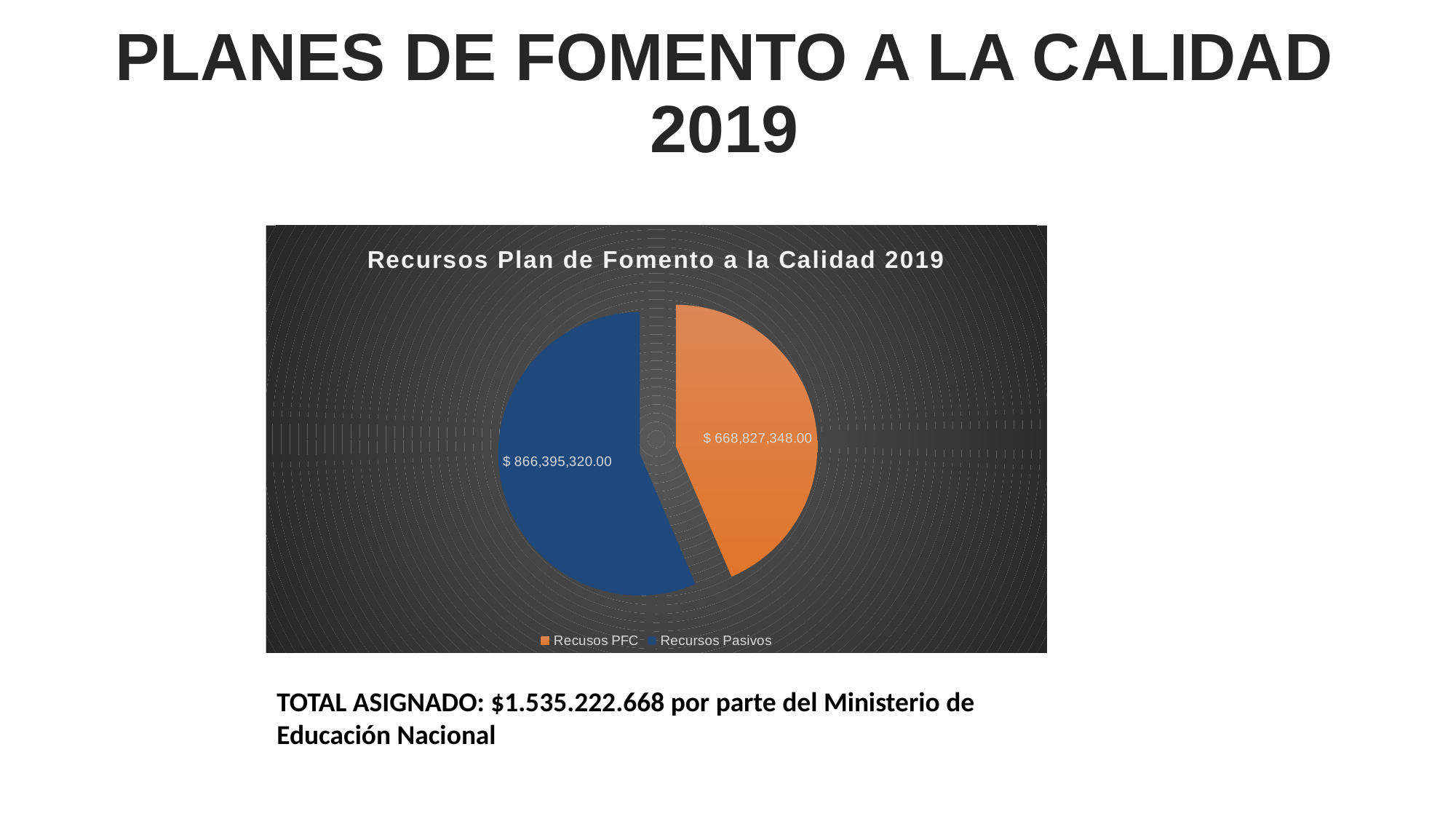
What colour is the Recursos Pasivos slice? blue What is the difference between Recursos Pasivos and Recusos PFC? $ 197,567,972.00 What is the value shown for Recursos Pasivos? $ 866,395,320.00 What is the total of the two slices in the pie chart? $ 1,535,222,668.00 What is the title of the chart? Recursos Plan de Fomento a la Calidad 2019 Which is larger, Recusos PFC or Recursos Pasivos? Recursos Pasivos Which category has the smallest slice of the pie? Recusos PFC What is the value shown for Recusos PFC? $ 668,827,348.00 How many slices does the pie chart have? 2 Which category has the largest slice of the pie? Recursos Pasivos How many entries does the legend list? 2 What type of chart is shown on the slide? pie chart